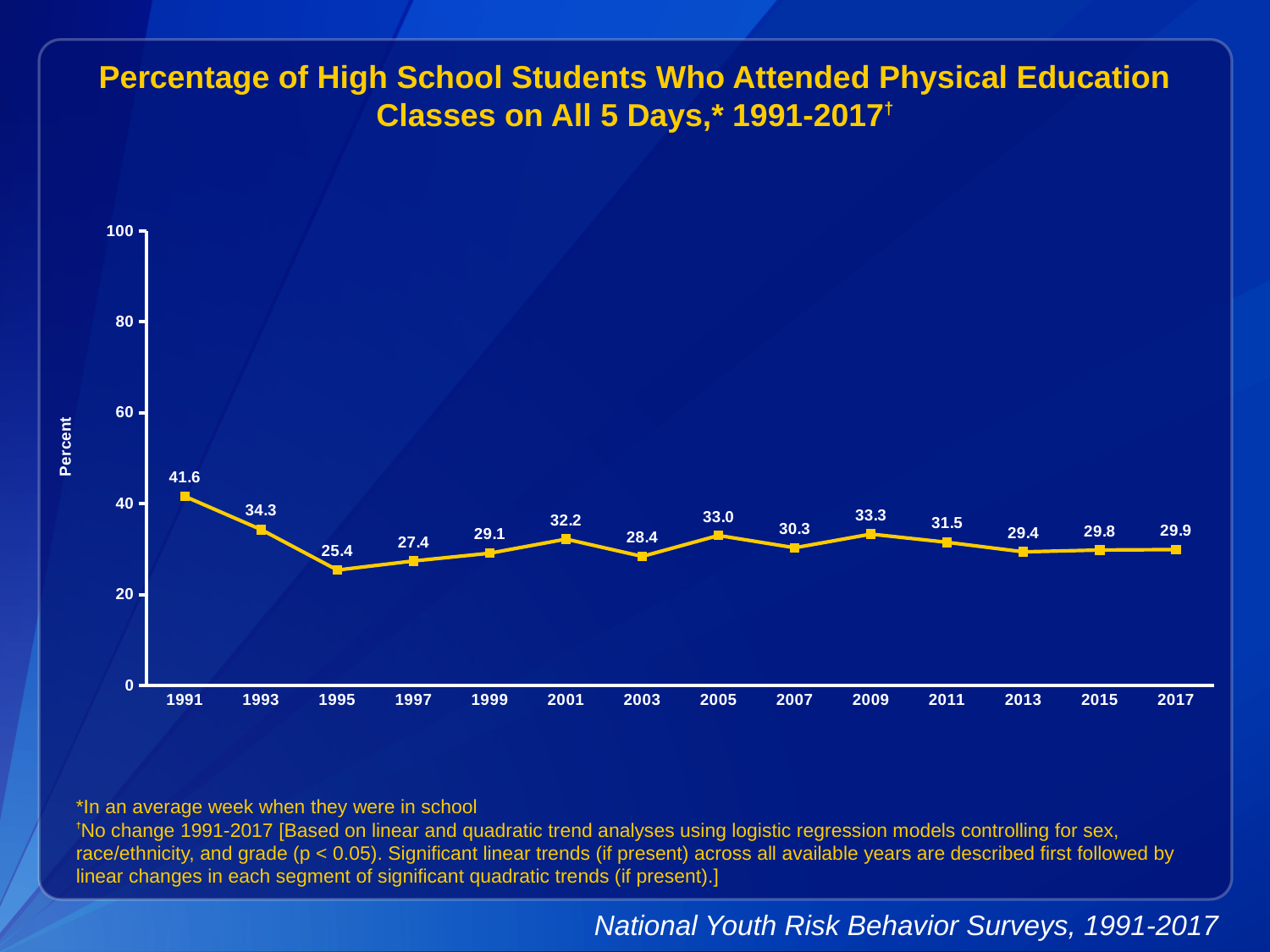
What is the difference between the values for 2009 and 2017? 3.4 What kind of chart is shown on the slide? line chart How many years are plotted on the x axis? 14 What is the label on the y axis? Percent Which year has the highest value on the chart? 1991 What is the value plotted for 2017? 29.9 Is the value for 1991 greater or less than 40? greater Which year has the larger value, 2001 or 2003? 2001 Which year has the lowest value on the chart? 1995 What is the difference between the values for 1991 and 1995? 16.2 What is the value plotted for 2003? 28.4 What percentage of high school students attended physical education classes on all 5 days in 1991? 41.6